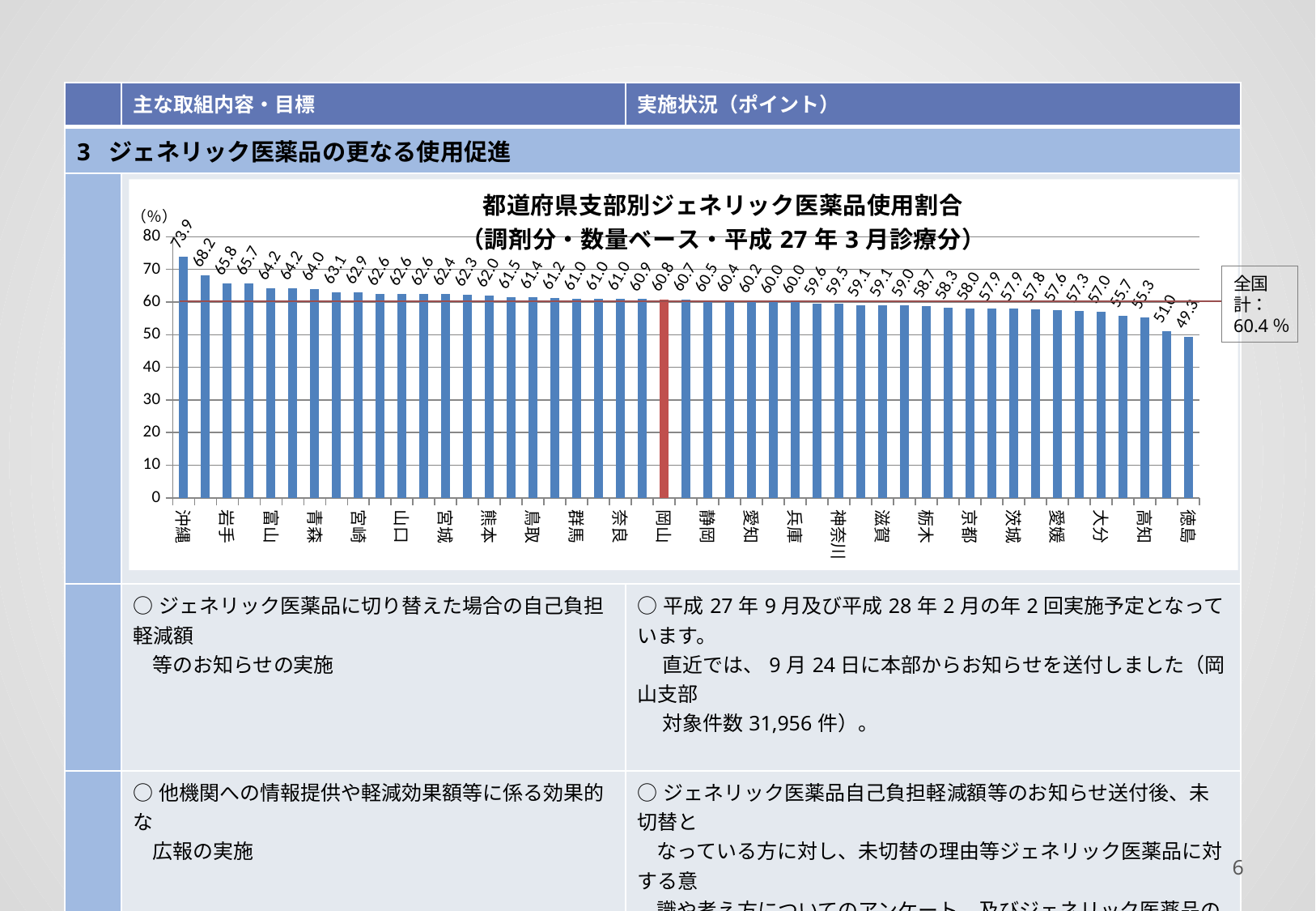
Which has a higher generic drug usage ratio, 岩手 or 高知? 岩手 What is the generic drug usage ratio for 徳島? 49.3 How many bars are plotted in the chart? 47 Do the values rise or fall from left to right along the x axis? fall Which prefecture branch has the highest generic drug usage ratio? 沖縄 What is the generic drug usage ratio for 沖縄? 73.9 What kind of chart is shown on the slide? bar chart What is the generic drug usage ratio for 岡山 (the red bar)? 60.8 Which prefecture branch has the lowest generic drug usage ratio? 徳島 What national total (全国計) is indicated by the horizontal line on the chart? 60.4% What is the difference between the usage ratios of 沖縄 and 徳島? 24.6 Is the value for 徳島 greater or less than 50? less